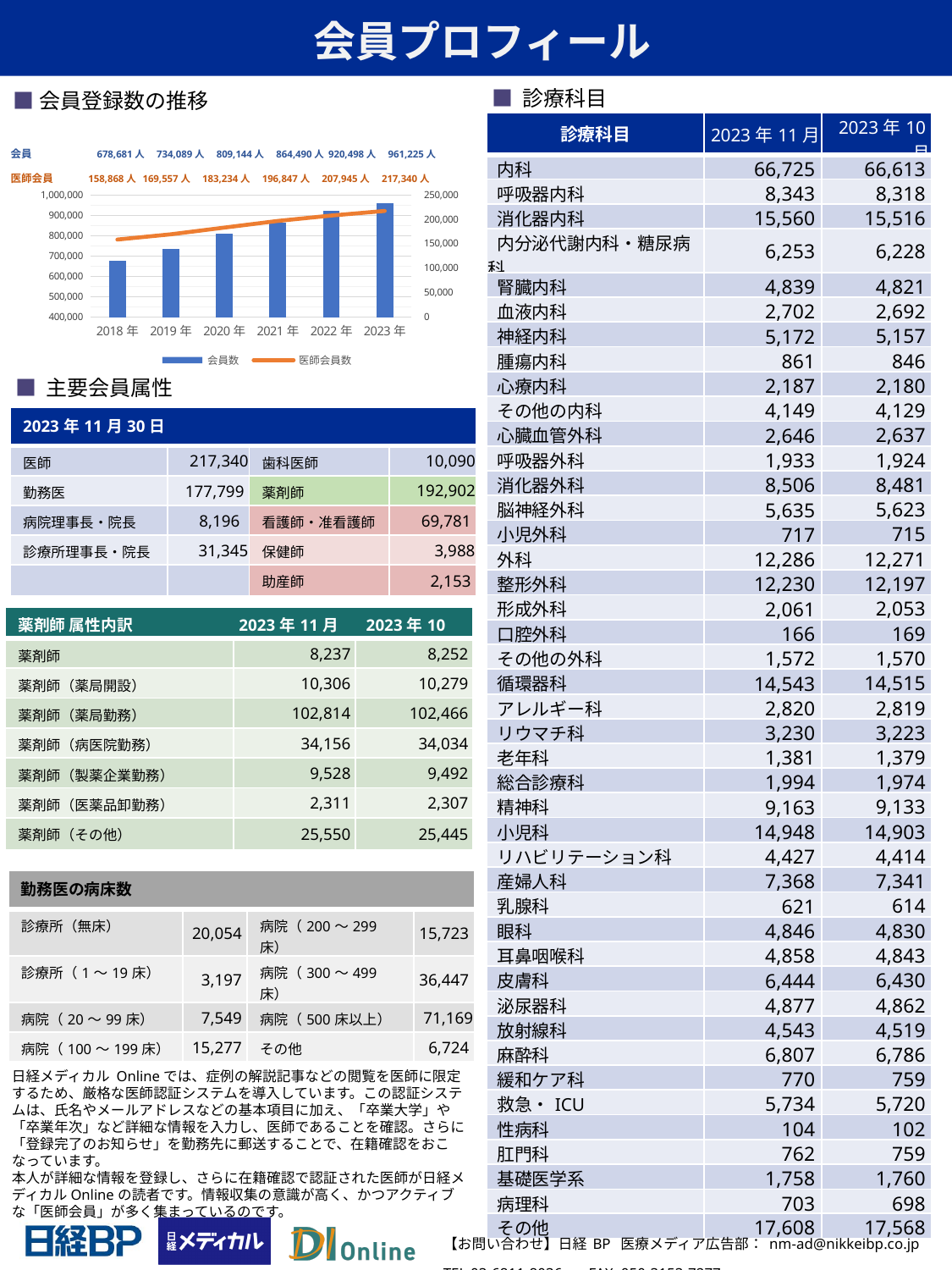
In the 会員登録数の推移 chart, is the 会員数 bar for 2018年 greater or less than 700,000? less How many years are shown on the x axis of the 会員登録数の推移 chart? 6 In the 会員登録数の推移 chart, what is the difference between the 医師会員 values for 2022年 and 2021年? 11,098人 In the 会員登録数の推移 chart, by how much did the 会員 value increase from 2018年 to 2023年? 282,544人 In the 会員登録数の推移 chart, do the 会員数 values rise or fall from 2018年 to 2023年? rise In the 会員登録数の推移 chart, which year has the lowest 医師会員数? 2018年 What kind of chart is the 会員登録数の推移 chart? bar and line chart In the 会員登録数の推移 chart, which year has the highest 会員数? 2023年 In the 会員登録数の推移 chart, which year has the larger 会員 value, 2019年 or 2021年? 2021年 In the 会員登録数の推移 chart, what is the 会員 value for 2020年? 809,144人 How many series does the legend of the 会員登録数の推移 chart list? 2 In the 会員登録数の推移 chart, what is the 医師会員 value for 2023年? 217,340人